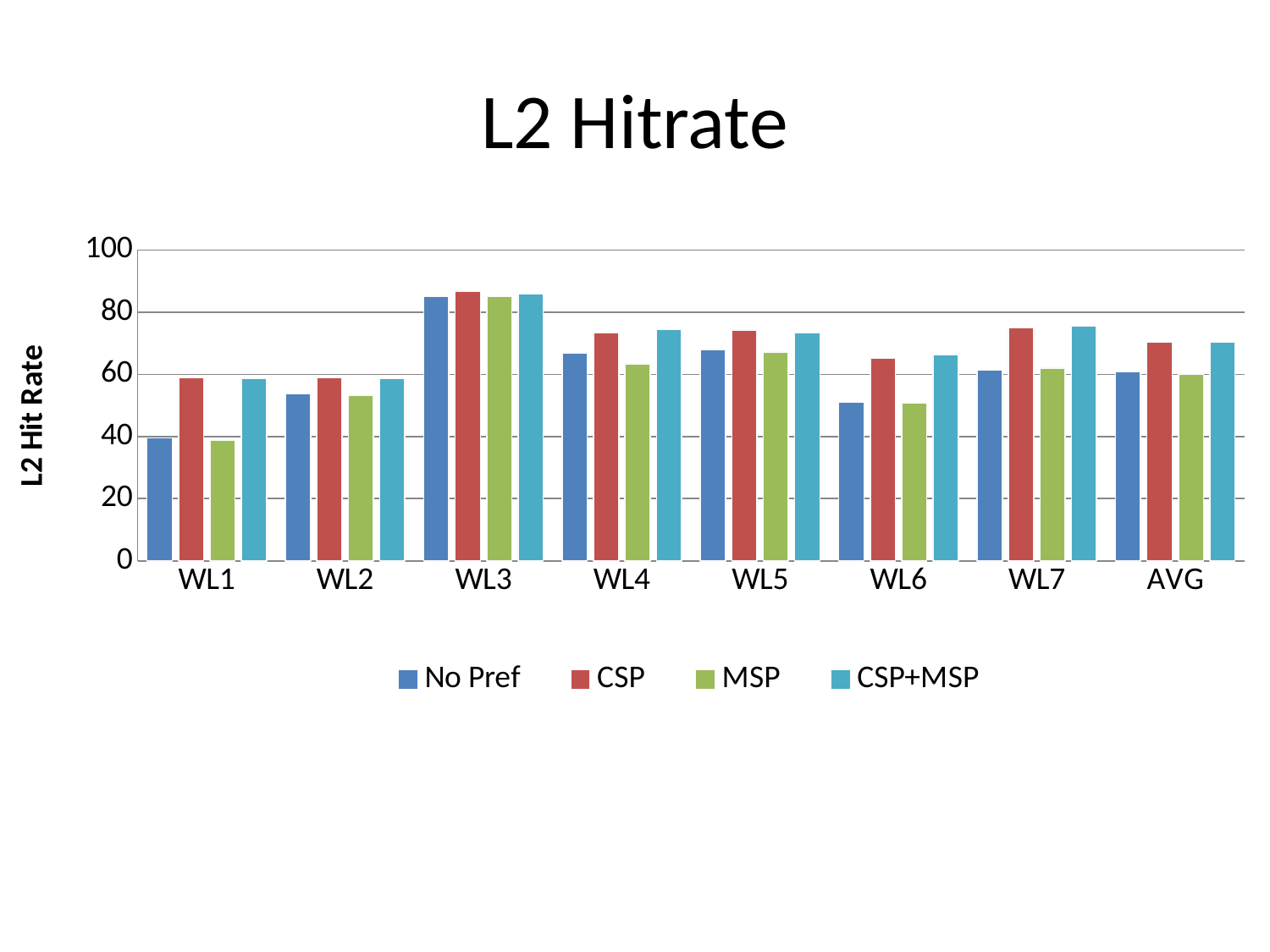
Which category has the lowest MSP value? WL1 Is the CSP value for WL7 greater or less than 60? greater Is the MSP value for WL6 greater or less than 60? less For WL4, which is larger: the CSP value or the MSP value? CSP What is the label on the y axis? L2 Hit Rate What is the title of the chart? L2 Hitrate How many categories are shown on the x axis? 8 For WL6, which is larger: the No Pref value or the CSP value? CSP Is the No Pref value for WL3 greater or less than 80? greater What kind of chart is shown on the slide? bar chart Which category has the highest No Pref value? WL3 How many series does the legend list? 4